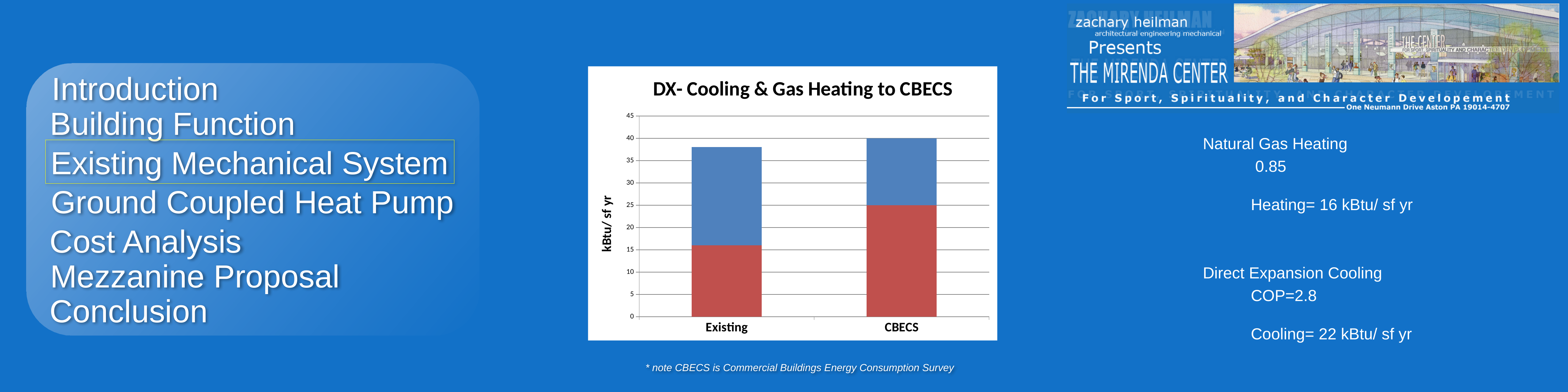
What is the value of the bottom (red) segment of the CBECS bar? 25 Is the total height of the Existing bar greater or less than 35? greater Which bar has the larger bottom (red) segment, Existing or CBECS? CBECS What kind of chart is shown on the slide? stacked bar chart What is the title of the chart? DX- Cooling & Gas Heating to CBECS What is the total height of the CBECS stacked bar? 40 How many categories are shown on the x axis of the chart? 2 Which bar is taller overall, Existing or CBECS? CBECS Which bar has the larger top (blue) segment, Existing or CBECS? Existing Is the bottom (red) segment of the Existing bar greater or less than 20? less What is the label on the chart's vertical axis? kBtu/ sf yr What is the highest value shown on the chart's vertical axis? 45